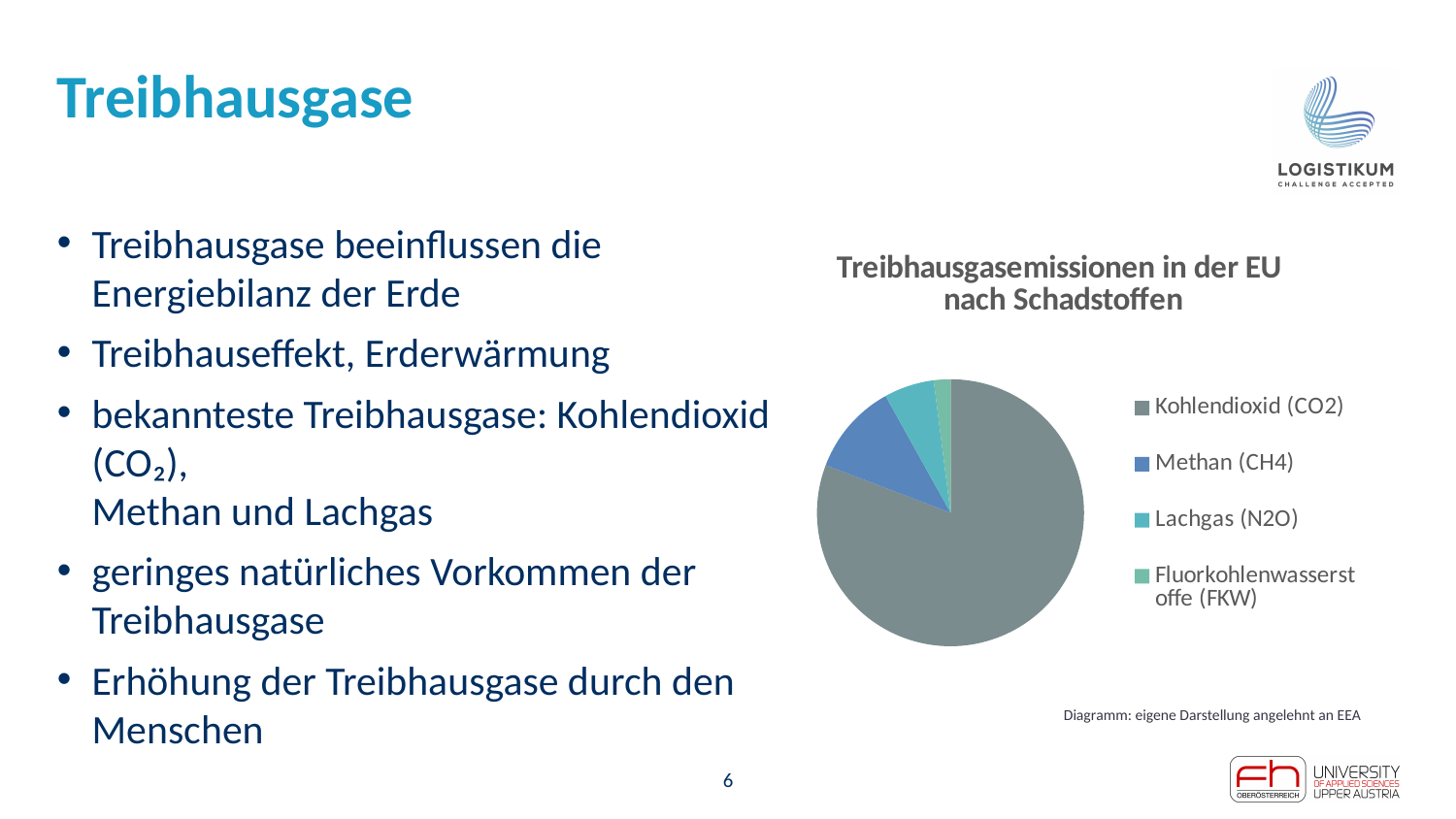
Which category is the second-largest slice in the pie chart? Methan (CH4) How many slices does the pie chart have? 4 Which slice is larger in the pie chart, Kohlendioxid (CO2) or Methan (CH4)? Kohlendioxid (CO2) What kind of chart is shown on the slide? pie chart Which slice is larger in the pie chart, Lachgas (N2O) or Fluorkohlenwasserstoffe (FKW)? Lachgas (N2O) Which legend entry of the pie chart is shown in grey? Kohlendioxid (CO2) Which slice is larger in the pie chart, Methan (CH4) or Lachgas (N2O)? Methan (CH4) Which category has the smallest slice in the pie chart? Fluorkohlenwasserstoffe (FKW) Which category has the largest slice in the pie chart? Kohlendioxid (CO2) What is the title of the pie chart? Treibhausgasemissionen in der EU nach Schadstoffen How many categories does the legend of the pie chart list? 4